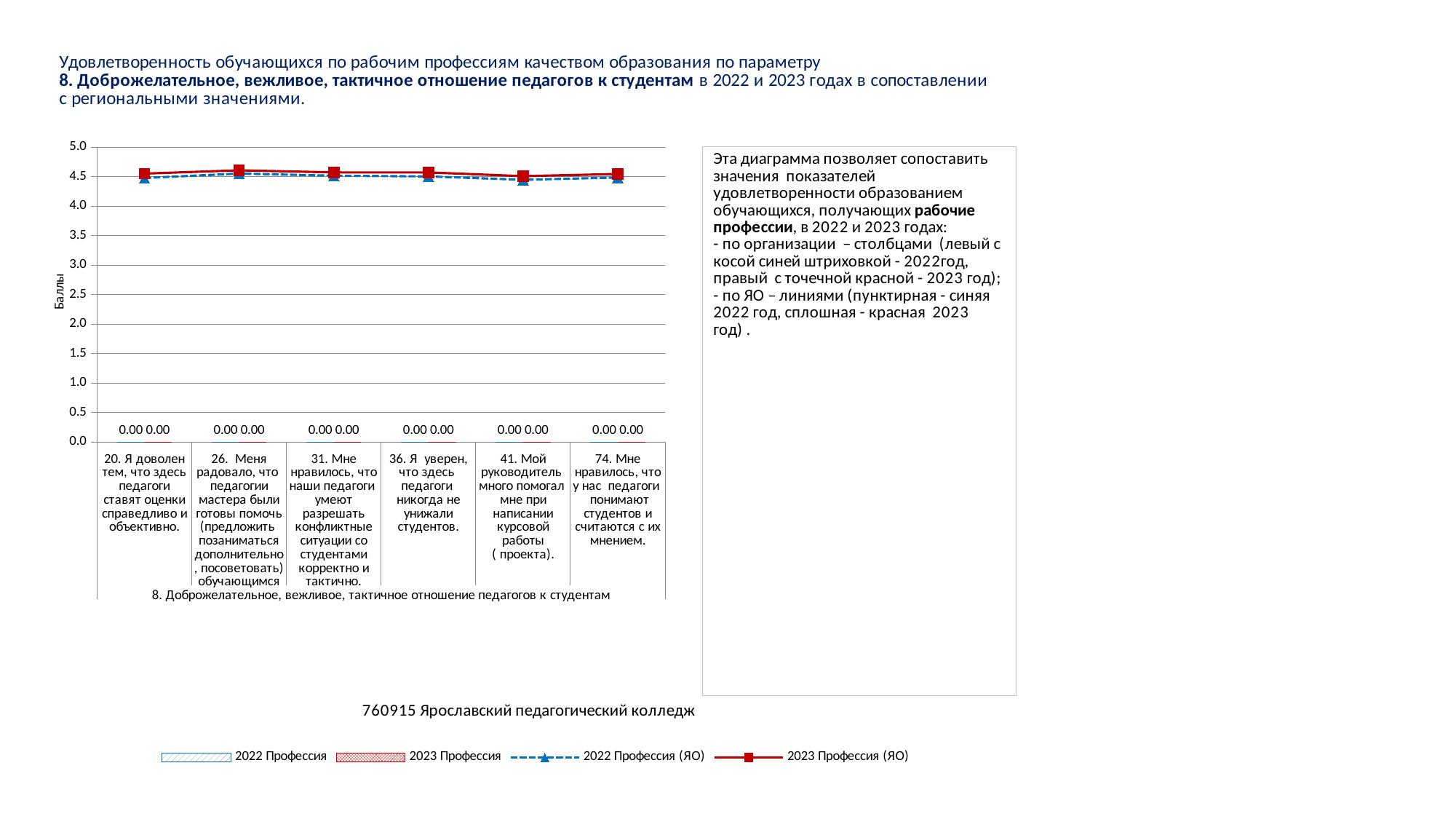
Which legend entry is drawn as a solid red line with square markers? 2023 Профессия (ЯО) Is the value of the 2023 Профессия (ЯО) line for category "26. Меня радовало, что педагоги мастера были готовы помочь..." greater or less than 4.0? greater How many categories (questions) are shown along the x axis of the chart? 6 For category "20. Я доволен тем, что здесь педагоги ставят оценки справедливо и объективно.", which line is higher: 2022 Профессия (ЯО) or 2023 Профессия (ЯО)? 2023 Профессия (ЯО) What is the value of the 2022 Профессия bar for category "20. Я доволен тем, что здесь педагоги ставят оценки справедливо и объективно."? 0.00 What kind of chart is shown on the slide? Combined bar and line chart Is the value of the 2023 Профессия (ЯО) line for category "36. Я уверен, что здесь педагоги никогда не унижали студентов." greater or less than 3.5? greater Is the value of the 2022 Профессия (ЯО) line for category "74. Мне нравилось, что у нас педагоги понимают студентов и считаются с их мнением." greater or less than 4.0? greater How many series does the chart legend list? 4 What is the value of the 2023 Профессия bar for category "74. Мне нравилось, что у нас педагоги понимают студентов и считаются с их мнением."? 0.00 What is the title of the vertical axis of the chart? Баллы What is the difference between the 2022 Профессия and 2023 Профессия bars for category "31. Мне нравилось, что наши педагоги умеют разрешать конфликтные ситуации со студентами корректно и тактично."? 0.00